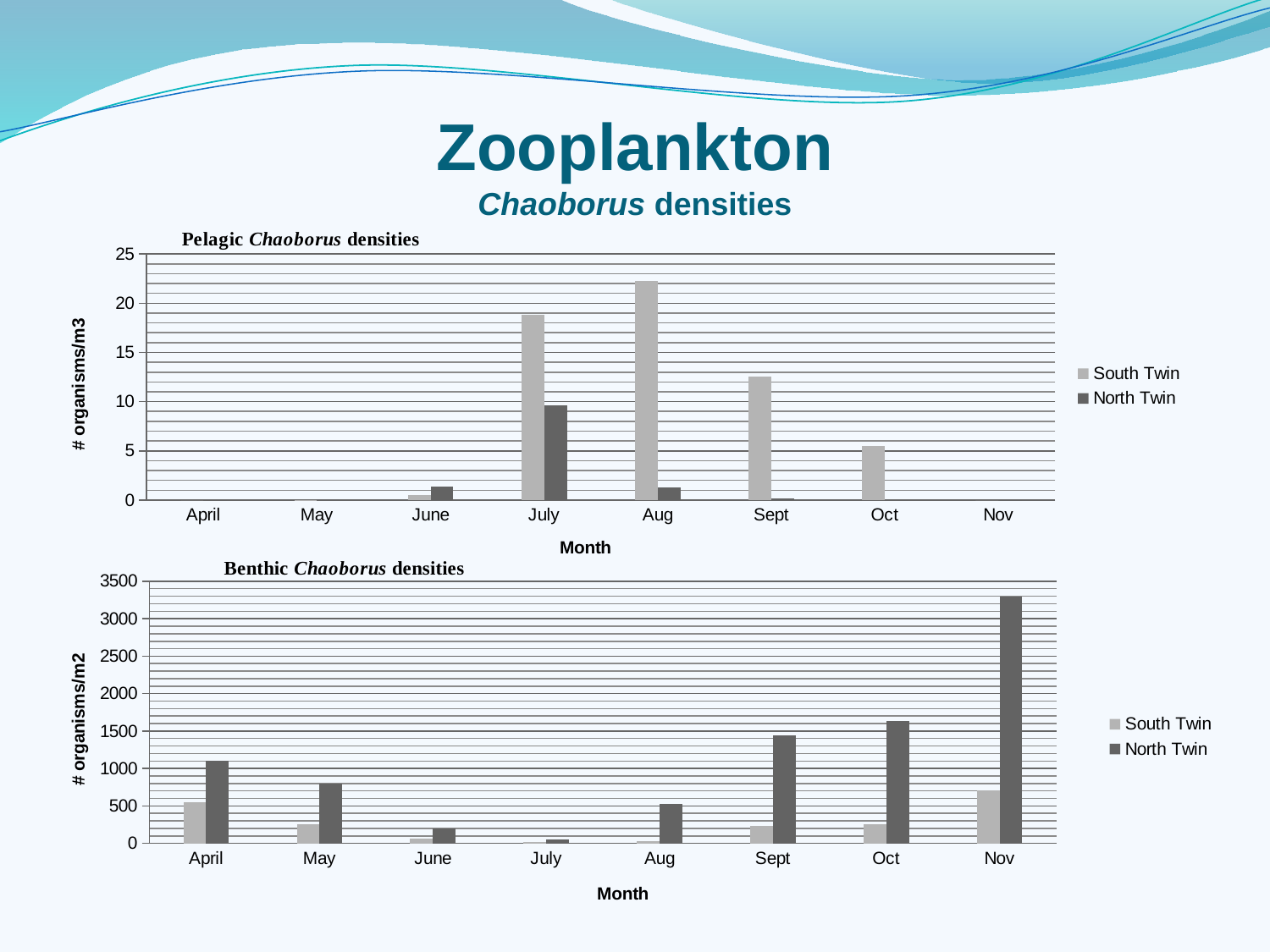
In the Benthic Chaoborus densities chart, which month has the highest North Twin value? Nov In the Benthic Chaoborus densities chart, which is larger for April, South Twin or North Twin? North Twin In the Pelagic Chaoborus densities chart, is the South Twin value for July greater or less than 15? greater In the Benthic Chaoborus densities chart, is the South Twin value for Nov greater or less than 500? greater What kind of chart is the Pelagic Chaoborus densities chart? bar chart In the Benthic Chaoborus densities chart, is the North Twin value for Nov greater or less than 3000? greater What is the y-axis label of the Benthic Chaoborus densities chart? # organisms/m2 In the Pelagic Chaoborus densities chart, which month has the highest South Twin value? Aug How many series does the legend of the Benthic Chaoborus densities chart list? 2 In the Pelagic Chaoborus densities chart, which month has the highest North Twin value? July How many months are shown on the x axis of the Pelagic Chaoborus densities chart? 8